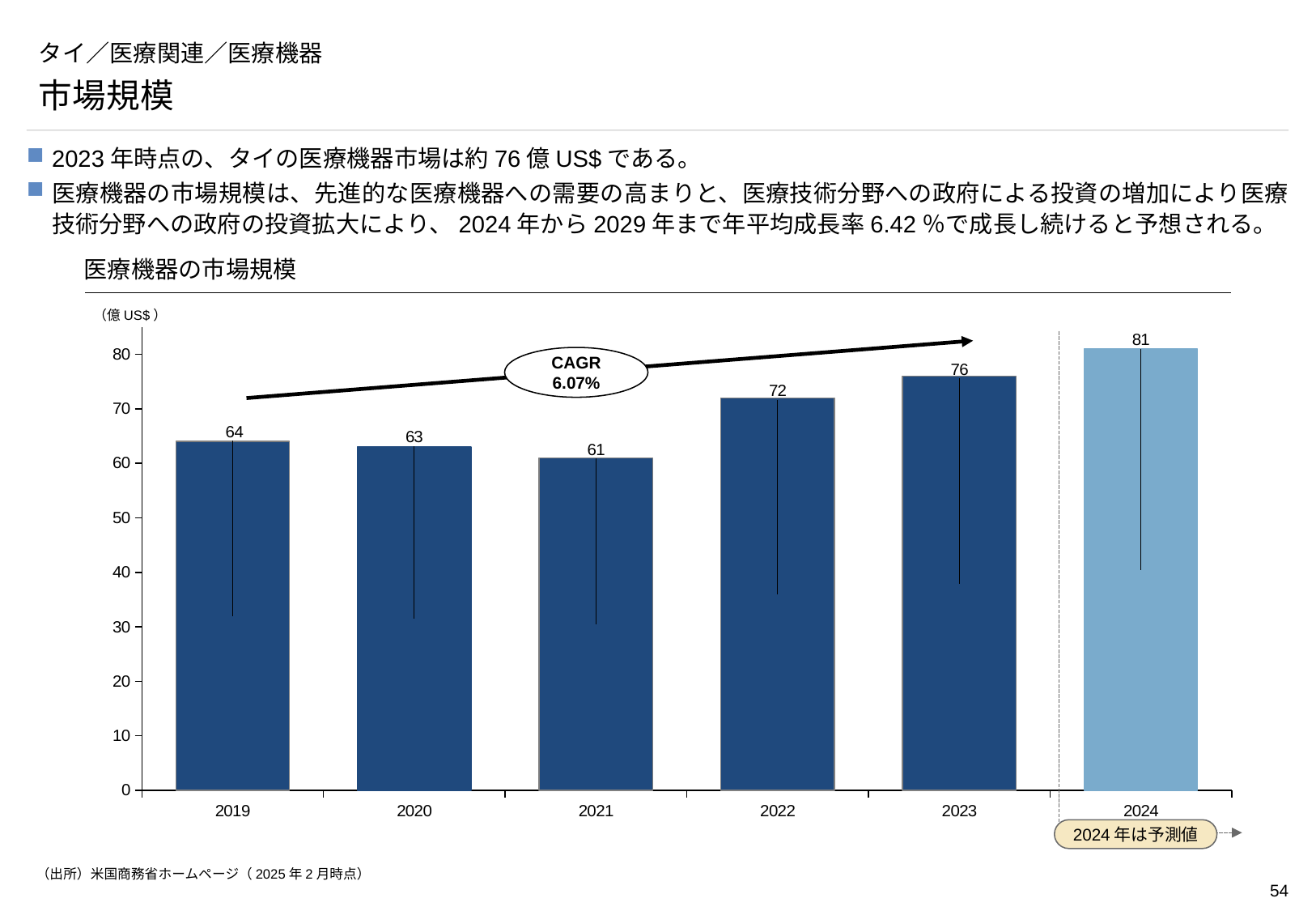
What is the value for 2023? 76 What kind of chart is this? bar chart What is the difference between the values for 2023 and 2019? 12 Which year has the highest value? 2024 Do the values rise or fall from 2021 to 2024? rise Which is larger, the value for 2020 or the value for 2022? 2022 How many years are shown on the x axis? 6 Is the value for 2021 greater or less than 70? less Which year has the lowest value? 2021 What is the value for 2024? 81 What CAGR is shown in the oval on the chart? 6.07% What is the value for 2019? 64